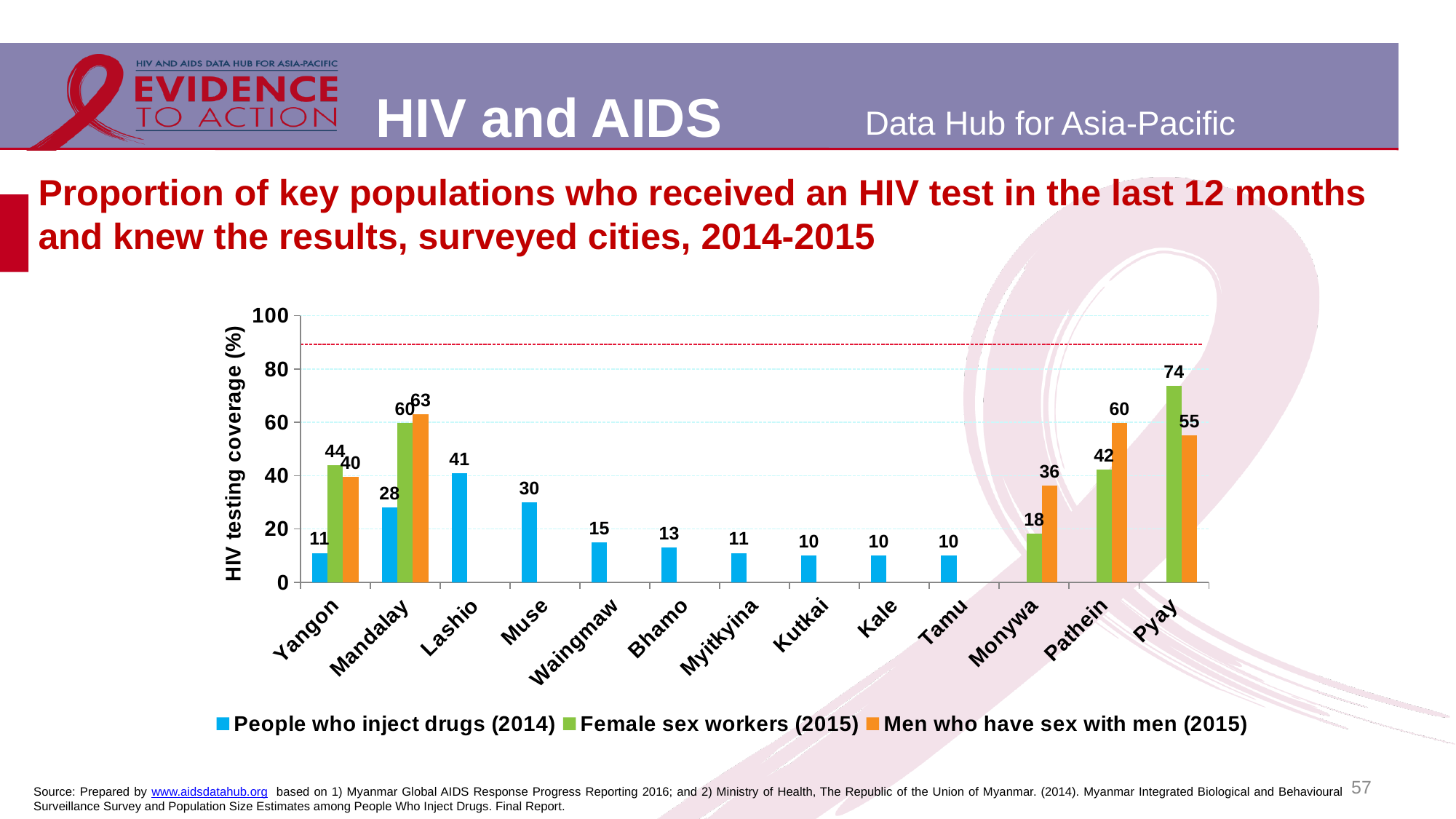
Is the value for people who inject drugs (2014) in Muse greater or less than 20? greater Which city has the highest HIV testing coverage for people who inject drugs (2014)? Lashio What is the HIV testing coverage for people who inject drugs (2014) in Lashio? 41 How many series does the legend list? 3 Which city has the lowest HIV testing coverage for female sex workers (2015)? Monywa What is the label of the y axis? HIV testing coverage (%) What kind of chart is shown on the slide? Bar chart How many cities are shown on the x axis of the chart? 13 What is the HIV testing coverage for female sex workers (2015) in Pyay? 74 In Mandalay, which is larger: the value for female sex workers (2015) or for men who have sex with men (2015)? Men who have sex with men (2015) What is the difference between the men who have sex with men (2015) value and the female sex workers (2015) value in Pathein? 18 What is the HIV testing coverage for men who have sex with men (2015) in Monywa? 36